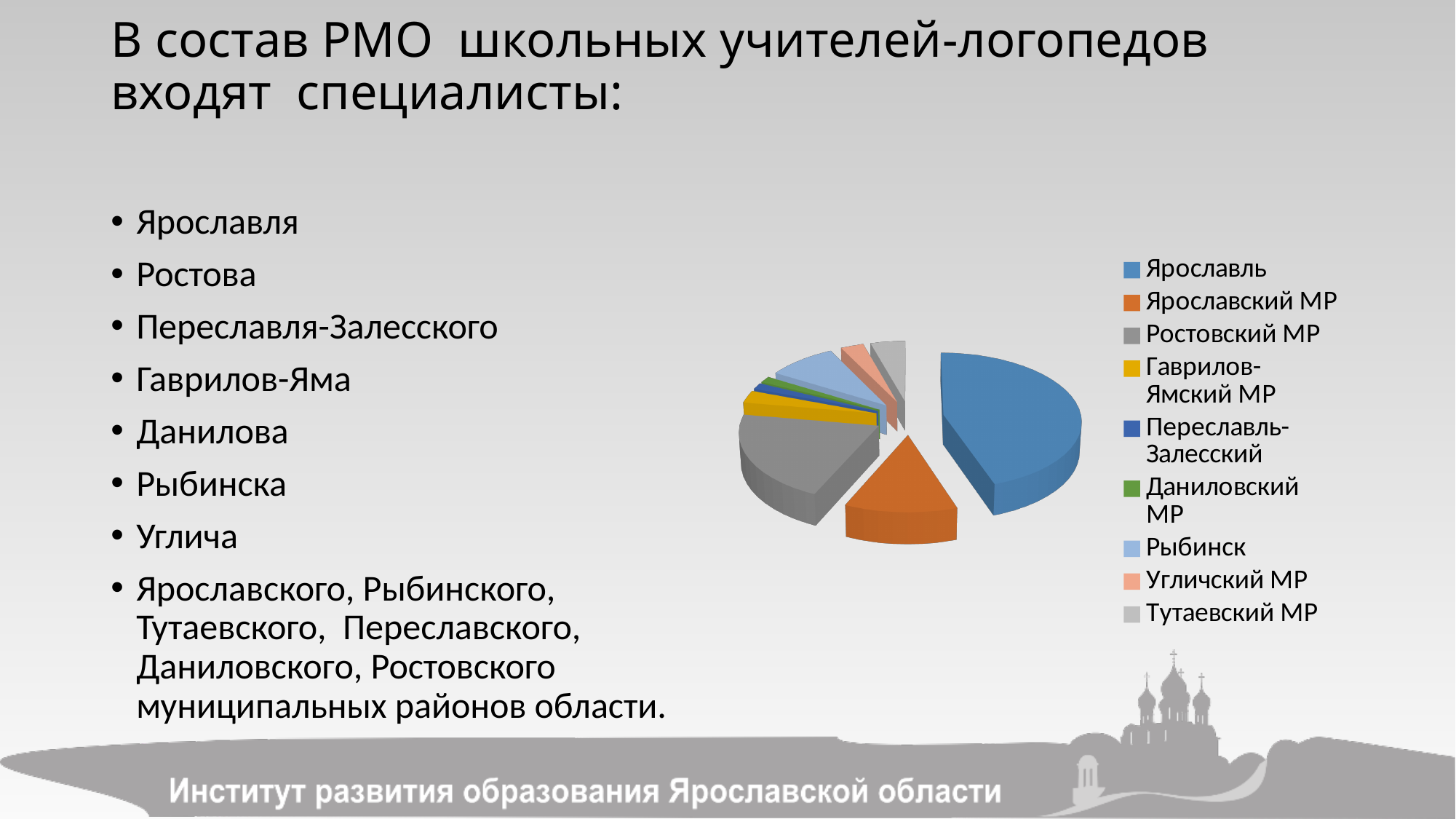
Which slice is larger in the pie chart, Ростовский МР or Ярославский МР? Ростовский МР What kind of chart is shown on the slide? pie chart Which slice is larger in the pie chart, Ярославль or Ярославский МР? Ярославль Which slice is larger in the pie chart, Ростовский МР or Рыбинск? Ростовский МР Which category is shown in orange in the pie chart? Ярославский МР How many categories does the pie chart's legend list? 9 What colour is the Ярославль slice in the pie chart? blue Which category has the largest slice in the pie chart? Ярославль